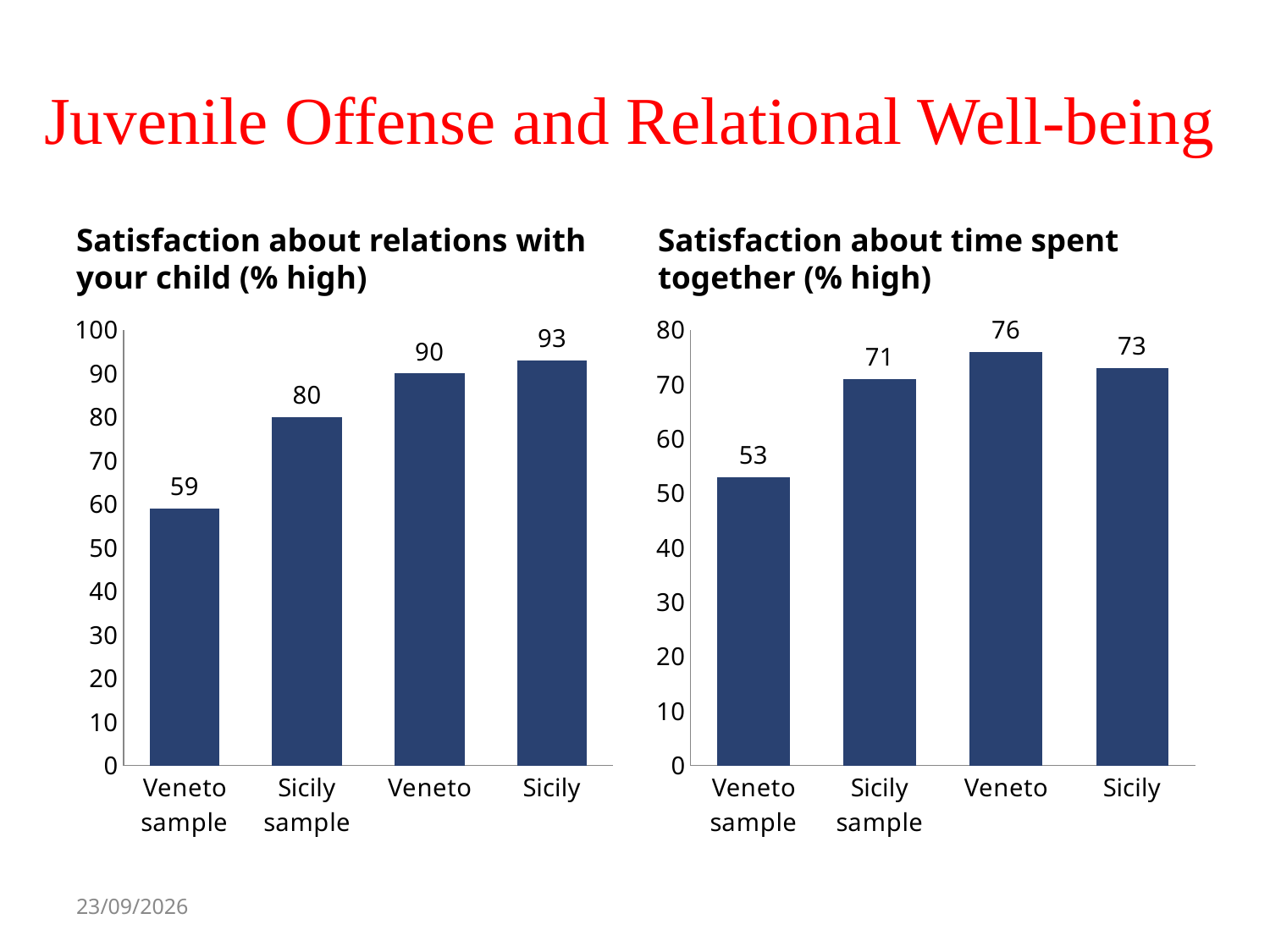
In the chart titled 'Satisfaction about relations with your child (% high)', what is the difference between the Sicily sample value and the Veneto sample value? 21 In the chart titled 'Satisfaction about time spent together (% high)', what is the maximum value shown on the vertical axis? 80 In the chart titled 'Satisfaction about time spent together (% high)', what is the value for the Sicily bar (the fourth bar)? 73 What type of chart is the chart titled 'Satisfaction about time spent together (% high)'? Bar chart In the chart titled 'Satisfaction about relations with your child (% high)', what is the value for Veneto sample? 59 In the chart titled 'Satisfaction about time spent together (% high)', what is the value for Veneto sample? 53 In the chart titled 'Satisfaction about time spent together (% high)', which is larger: the Sicily sample value or the Veneto (third bar) value? Veneto In the chart titled 'Satisfaction about relations with your child (% high)', what is the value for Sicily sample? 80 In the chart titled 'Satisfaction about time spent together (% high)', which category has the lowest value? Veneto sample In the chart titled 'Satisfaction about relations with your child (% high)', which category has the highest value? Sicily In the chart titled 'Satisfaction about time spent together (% high)', what is the difference between the Veneto bar (third bar) and the Sicily bar (fourth bar)? 3 How many bars are plotted in the chart titled 'Satisfaction about relations with your child (% high)'? 4